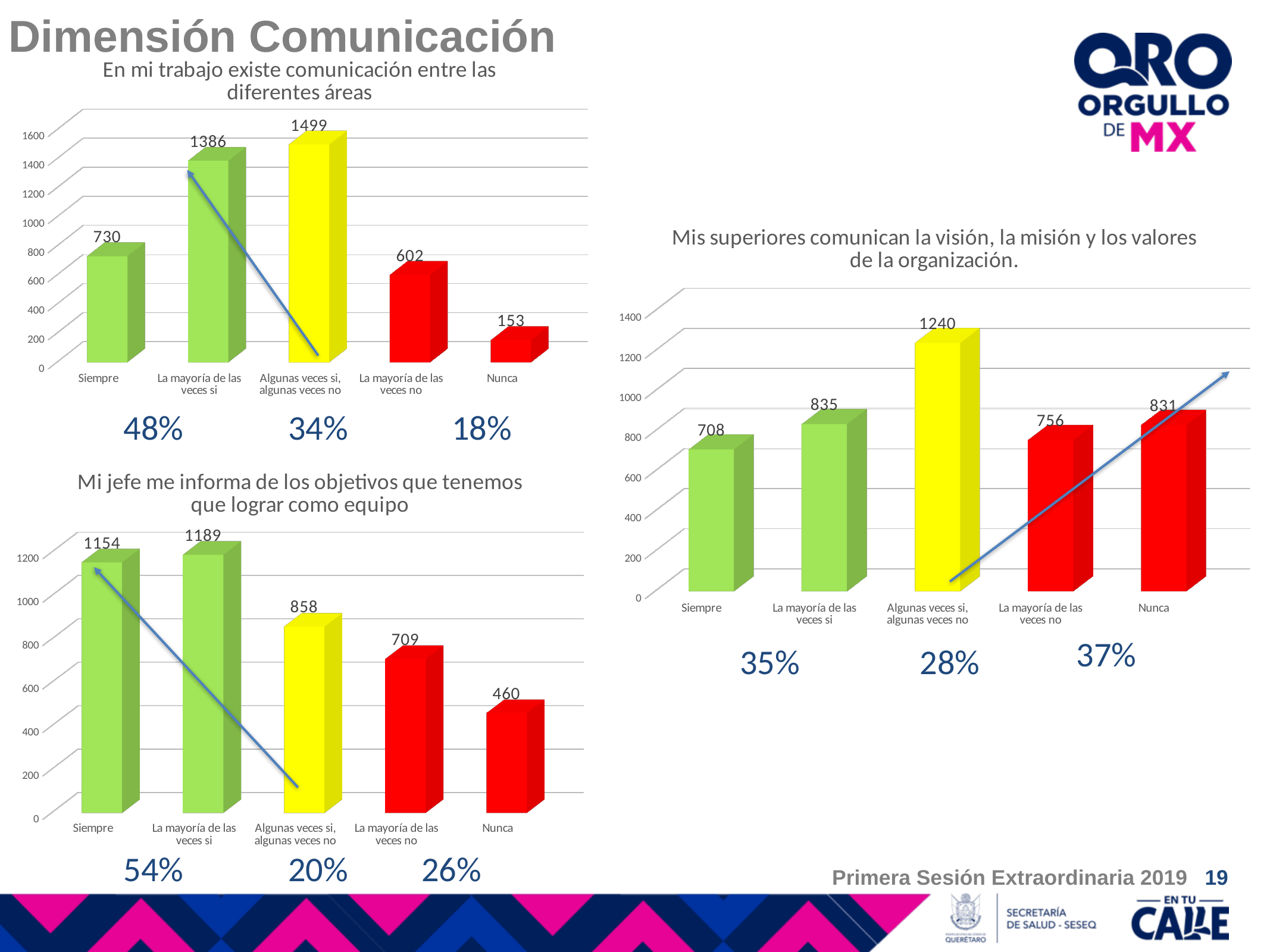
In the chart titled "Mis superiores comunican la visión, la misión y los valores de la organización.", what is the value for "Siempre"? 708 In the chart titled "En mi trabajo existe comunicación entre las diferentes áreas", what is the value for "Algunas veces si, algunas veces no"? 1499 In the chart titled "Mi jefe me informa de los objetivos que tenemos que lograr como equipo", what is the value for "Nunca"? 460 In the chart titled "En mi trabajo existe comunicación entre las diferentes áreas", which category has the lowest value? Nunca In the chart titled "Mi jefe me informa de los objetivos que tenemos que lograr como equipo", which is larger: "Algunas veces si, algunas veces no" or "La mayoría de las veces no"? Algunas veces si, algunas veces no What kind of chart is the chart titled "En mi trabajo existe comunicación entre las diferentes áreas"? Bar chart How many categories does the chart titled "Mis superiores comunican la visión, la misión y los valores de la organización." show? 5 In the chart titled "Mi jefe me informa de los objetivos que tenemos que lograr como equipo", what colour are the bars for "La mayoría de las veces no" and "Nunca"? Red In the chart titled "Mis superiores comunican la visión, la misión y los valores de la organización.", what is the difference between "Nunca" and "La mayoría de las veces no"? 75 In the chart titled "En mi trabajo existe comunicación entre las diferentes áreas", what is the difference between "La mayoría de las veces si" and "Siempre"? 656 In the chart titled "Mis superiores comunican la visión, la misión y los valores de la organización.", which category has the highest value? Algunas veces si, algunas veces no In the chart titled "Mi jefe me informa de los objetivos que tenemos que lograr como equipo", which category has the highest value? La mayoría de las veces si